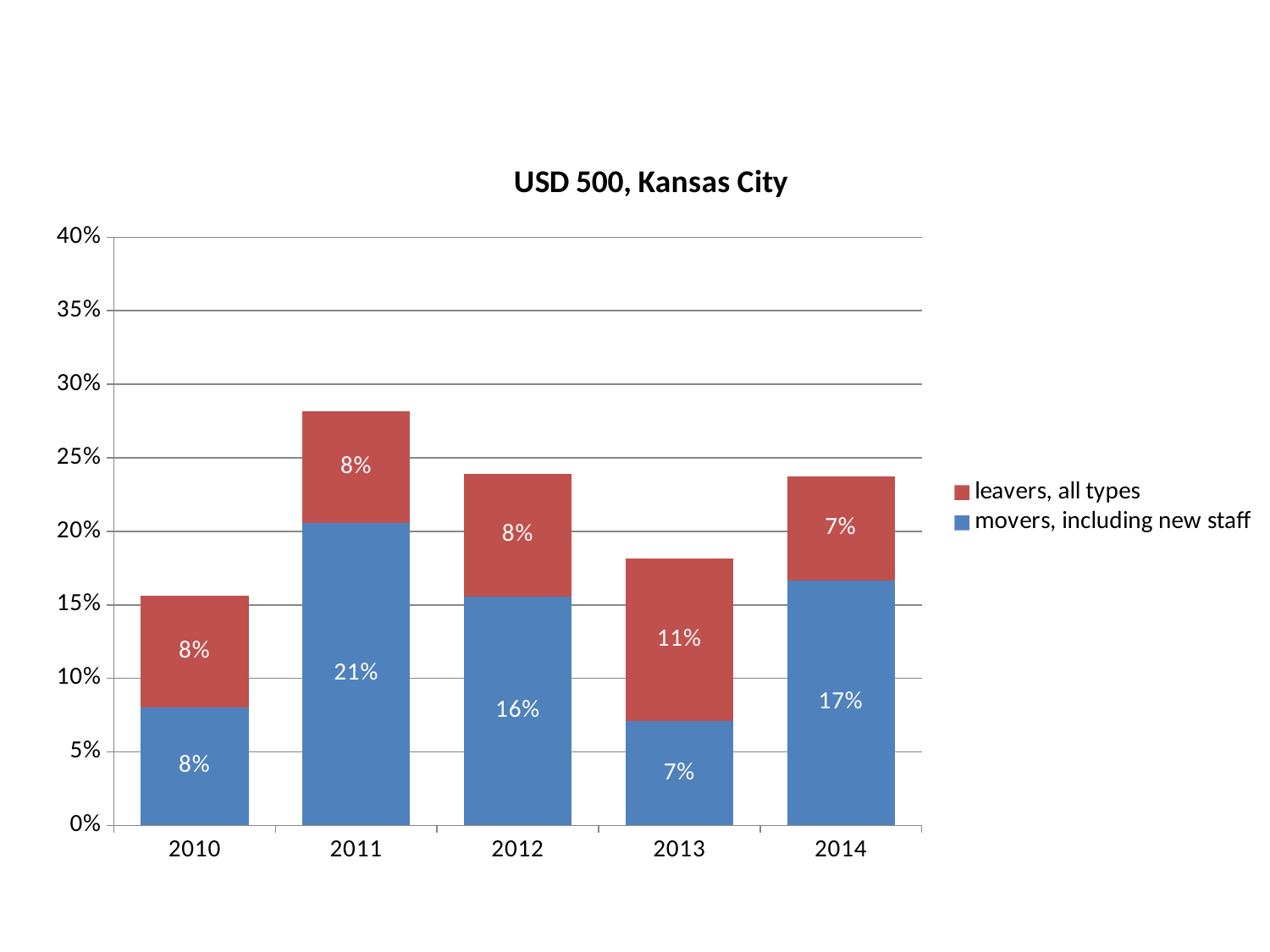
What is the value for movers, including new staff in 2014? 17% Which year has the highest value for movers, including new staff? 2011 Which year has the highest value for leavers, all types? 2013 What kind of chart is shown on the slide? Stacked bar chart Which year has the lowest value for movers, including new staff? 2013 How many series does the legend list? 2 How many years are shown on the x axis? 5 What is the value for movers, including new staff in 2011? 21% What is the difference between the movers, including new staff values for 2011 and 2013? 14 percentage points Which is larger, the movers, including new staff value for 2012 or for 2014? 2014 Is the total height of the 2011 stacked bar greater or less than 25%? greater What is the value for leavers, all types in 2013? 11%